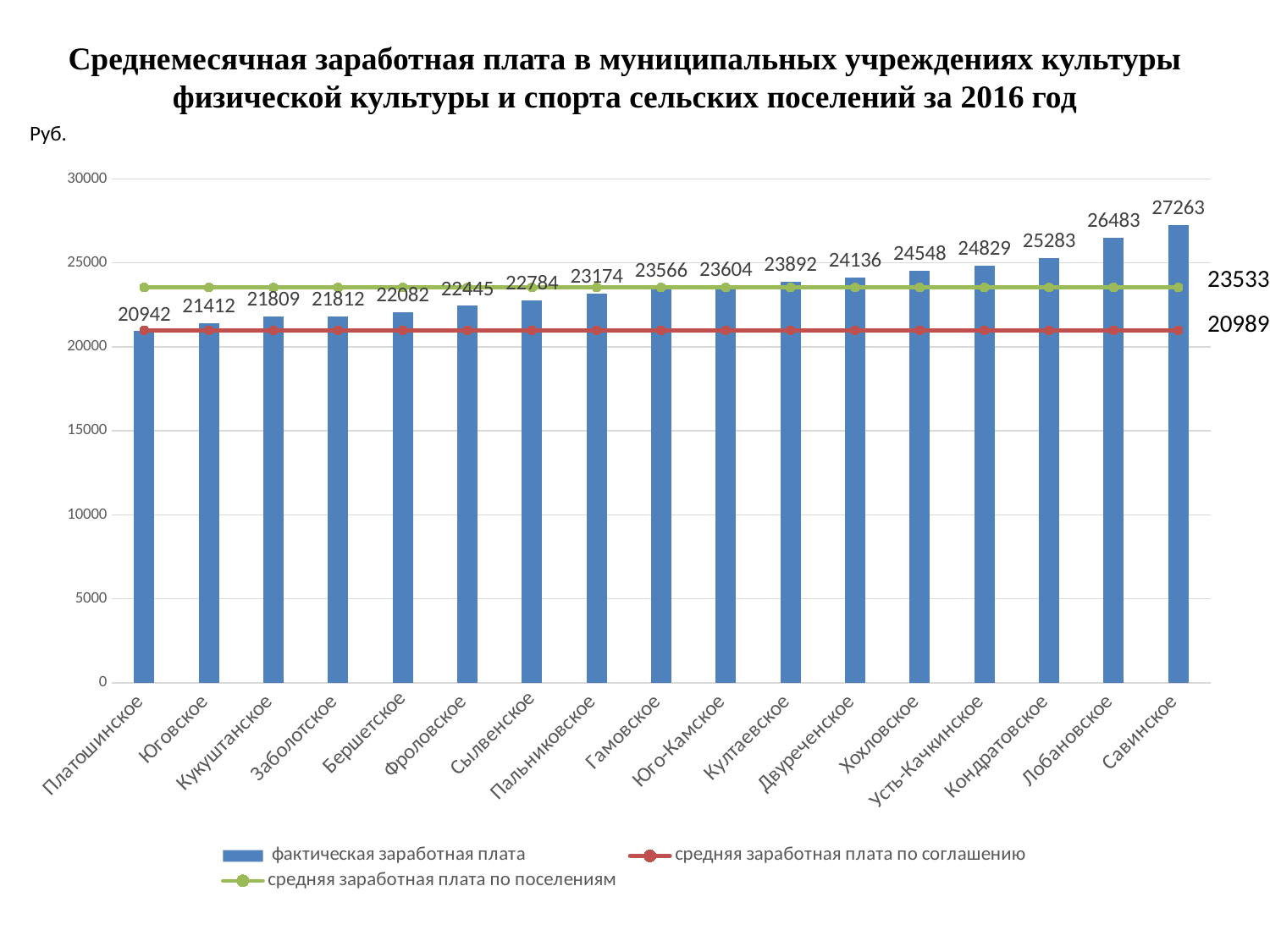
What is the difference between the actual salary in Савинское and in Платошинское? 6321 Do the actual salary bars rise or fall from left to right along the x axis? rise How many settlements are shown on the x axis? 17 Which settlement has the lowest actual average monthly salary? Платошинское Which settlement has the highest actual average monthly salary? Савинское What is the actual average monthly salary for Фроловское? 22445 What value does the green line 'средняя заработная плата по поселениям' show? 23533 Which has a higher actual salary, Кондратовское or Хохловское? Кондратовское Is the actual salary for Лобановское greater or less than 25000? greater What value does the red line 'средняя заработная плата по соглашению' show? 20989 How many series does the legend list? 3 What is the actual average monthly salary (фактическая заработная плата) for Савинское? 27263